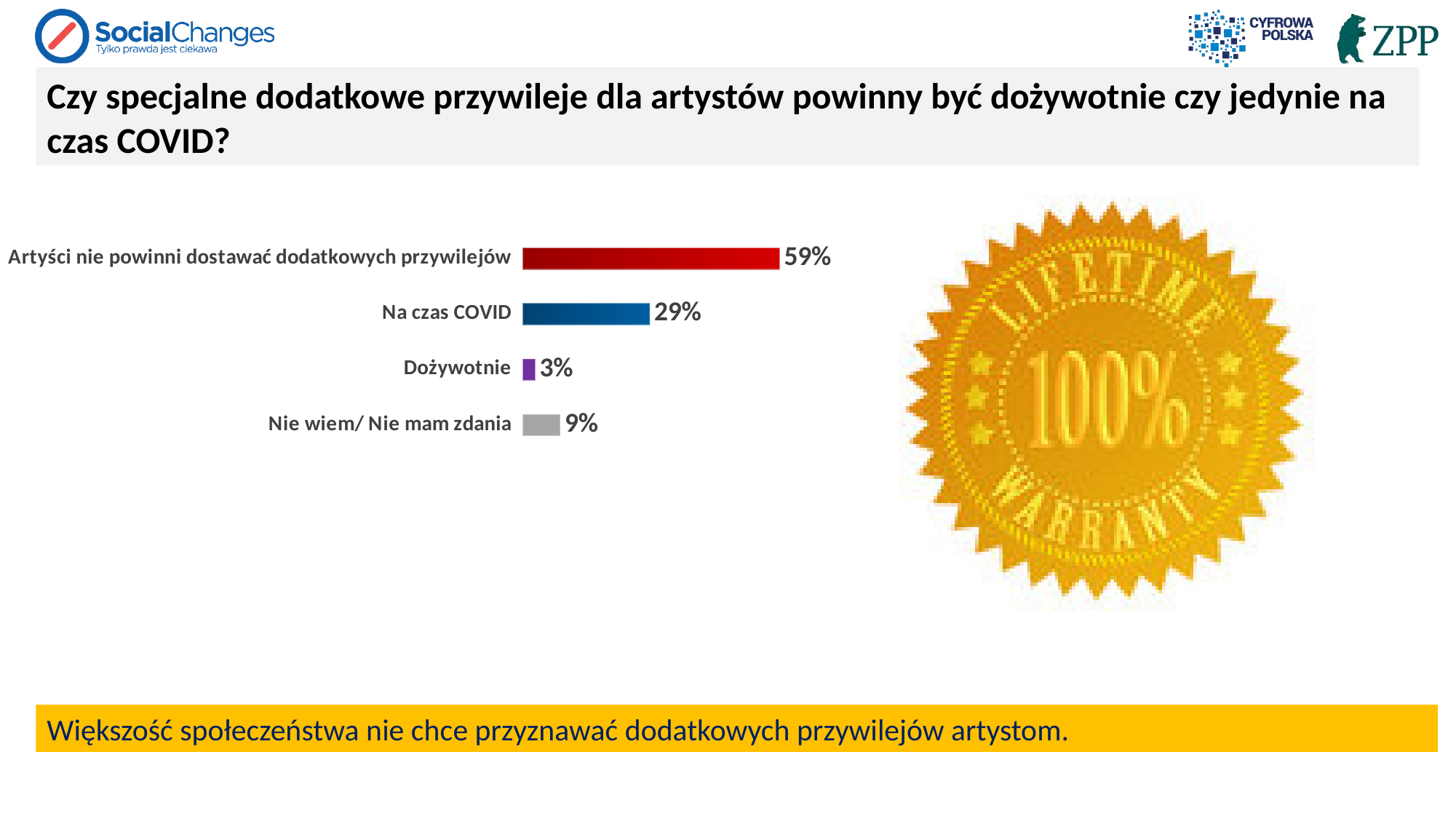
Which category has the lowest value? Dożywotnie What is the difference between the values for "Artyści nie powinni dostawać dodatkowych przywilejów" and "Na czas COVID"? 30% What is the value for "Artyści nie powinni dostawać dodatkowych przywilejów"? 59% What colour is the bar for "Na czas COVID"? Blue What is the difference between the values for "Nie wiem/ Nie mam zdania" and "Dożywotnie"? 6% What is the value for "Nie wiem/ Nie mam zdania"? 9% How many categories are shown in the chart? 4 What is the value for "Dożywotnie"? 3% What is the value for "Na czas COVID"? 29% Which category has the highest value? Artyści nie powinni dostawać dodatkowych przywilejów What kind of chart is shown on the slide? Bar chart Which is larger, the value for "Na czas COVID" or the value for "Nie wiem/ Nie mam zdania"? Na czas COVID